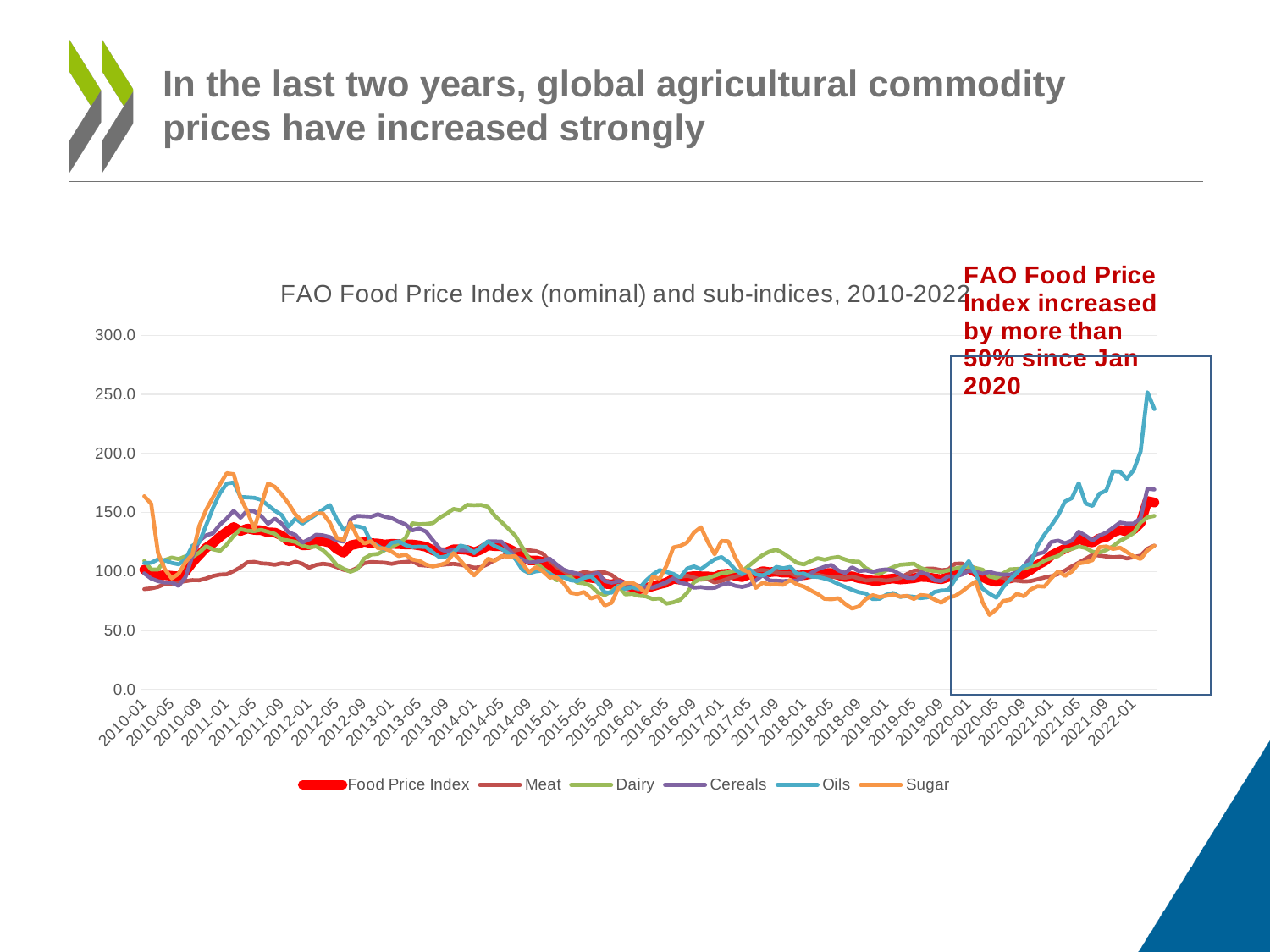
Is the value for Sugar around 2020-05 greater or less than 100? less Is the peak value for Sugar in 2011 greater or less than 150? greater Does the Oils series rise or fall between 2020-05 and 2022-01? rise Does the Food Price Index rise or fall between 2011 and 2016? fall How many series does the legend list? 6 According to the annotation on the chart, by how much has the FAO Food Price Index increased since Jan 2020? by more than 50% What kind of chart is shown on the slide? line chart Which series is highest at the end of the chart (2022)? Oils Which series reaches the highest value on the chart? Oils Is the value for the Food Price Index at the start of 2022 greater or less than 100? greater What is the title of the chart? FAO Food Price Index (nominal) and sub-indices, 2010-2022